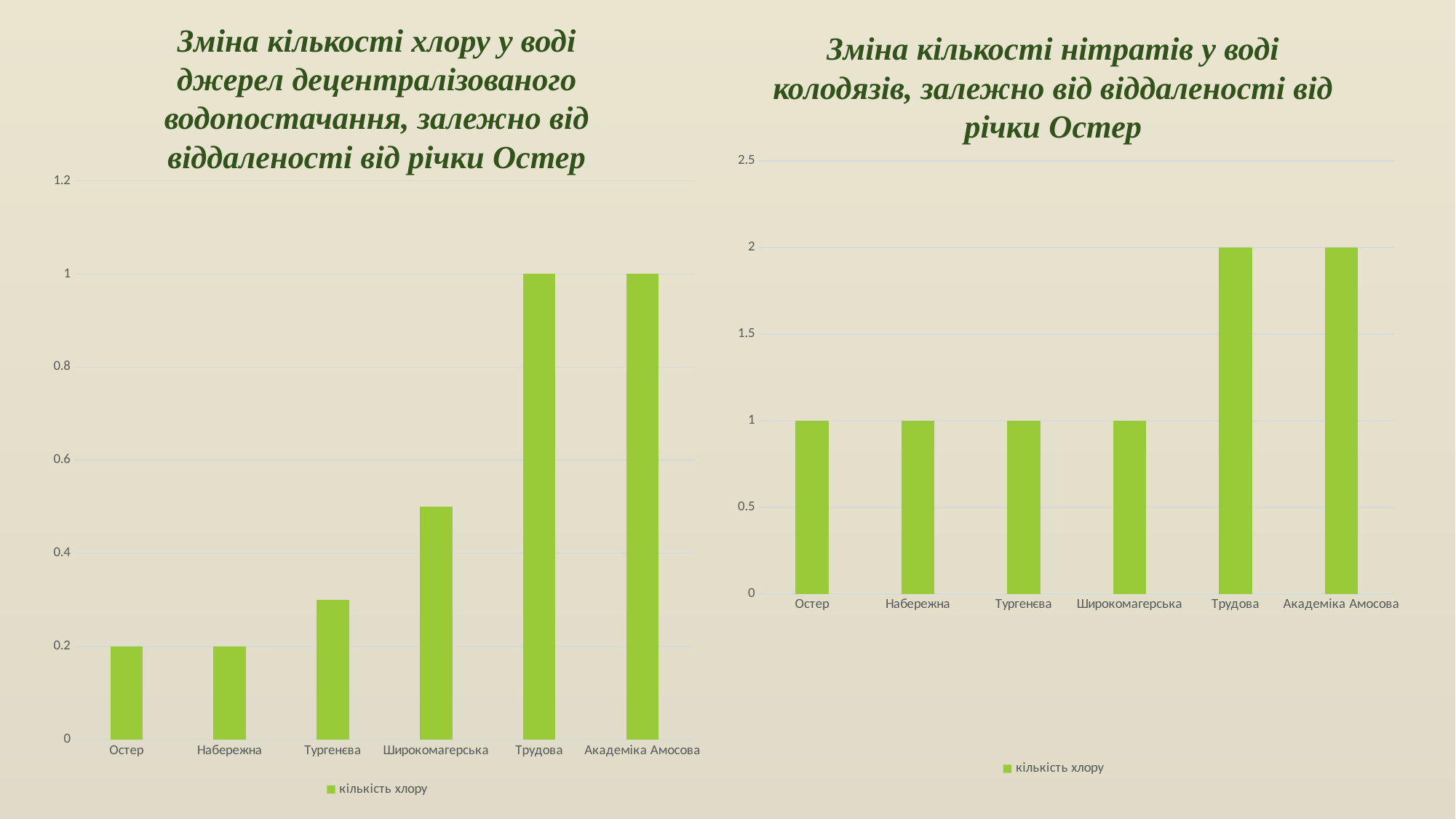
In the right chart (Зміна кількості нітратів у воді колодязів...), what is the difference between the values for Академіка Амосова and Набережна? 1 In the left chart (Зміна кількості хлору у воді...), which is larger, the value for Широкомагерська or the value for Набережна? Широкомагерська In the left chart (Зміна кількості хлору у воді...), what is the value for Остер? 0.2 In the left chart (Зміна кількості хлору у воді...), do the values generally rise or fall from Остер to Академіка Амосова? rise In the left chart (Зміна кількості хлору у воді...), is the value for Широкомагерська greater or less than 0.4? greater What kind of chart is the left chart (Зміна кількості хлору у воді...)? bar chart How many categories are shown on the x axis of the right chart (Зміна кількості нітратів у воді колодязів...)? 6 In the left chart (Зміна кількості хлору у воді...), is the value for Тургенєва greater or less than 0.4? less In the right chart (Зміна кількості нітратів у воді колодязів...), what is the value for Трудова? 2 In the right chart (Зміна кількості нітратів у воді колодязів...), what is the value for Широкомагерська? 1 In the left chart (Зміна кількості хлору у воді...), what is the difference between the values for Трудова and Остер? 0.8 In the left chart (Зміна кількості хлору у воді...), what is the value for Трудова? 1